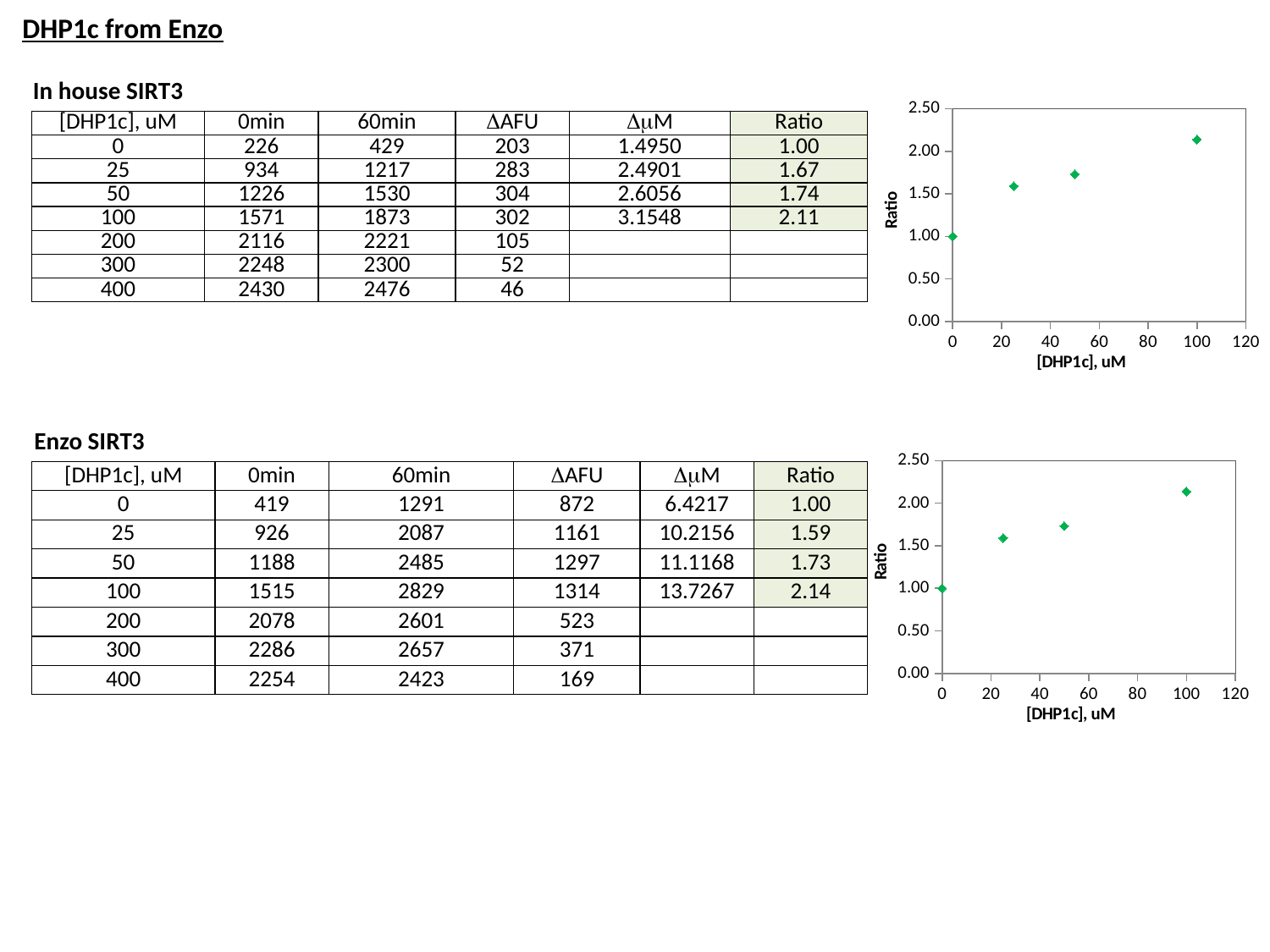
In the upper chart on the right of the slide, do the Ratio values rise or fall as [DHP1c], uM increases? rise In the upper chart on the right of the slide, what is the Ratio at [DHP1c] = 0 uM? 1.00 What is the x-axis label of the lower chart on the right of the slide? [DHP1c], uM In the upper chart on the right of the slide, which has the larger Ratio: [DHP1c] = 25 uM or [DHP1c] = 100 uM? 100 uM In the upper chart on the right of the slide, at which [DHP1c] concentration is the Ratio lowest? 0 In the upper chart on the right of the slide, at which [DHP1c] concentration is the Ratio highest? 100 What kind of chart is the upper chart on the right of the slide? scatter chart In the upper chart on the right of the slide, is the Ratio at [DHP1c] = 100 uM greater or less than 2.00? greater How many data points are plotted in the lower chart on the right of the slide? 4 What is the y-axis label of the lower chart on the right of the slide? Ratio How many data points are plotted in the upper chart on the right of the slide? 4 In the lower chart on the right of the slide, is the Ratio at [DHP1c] = 50 uM greater or less than 2.00? less